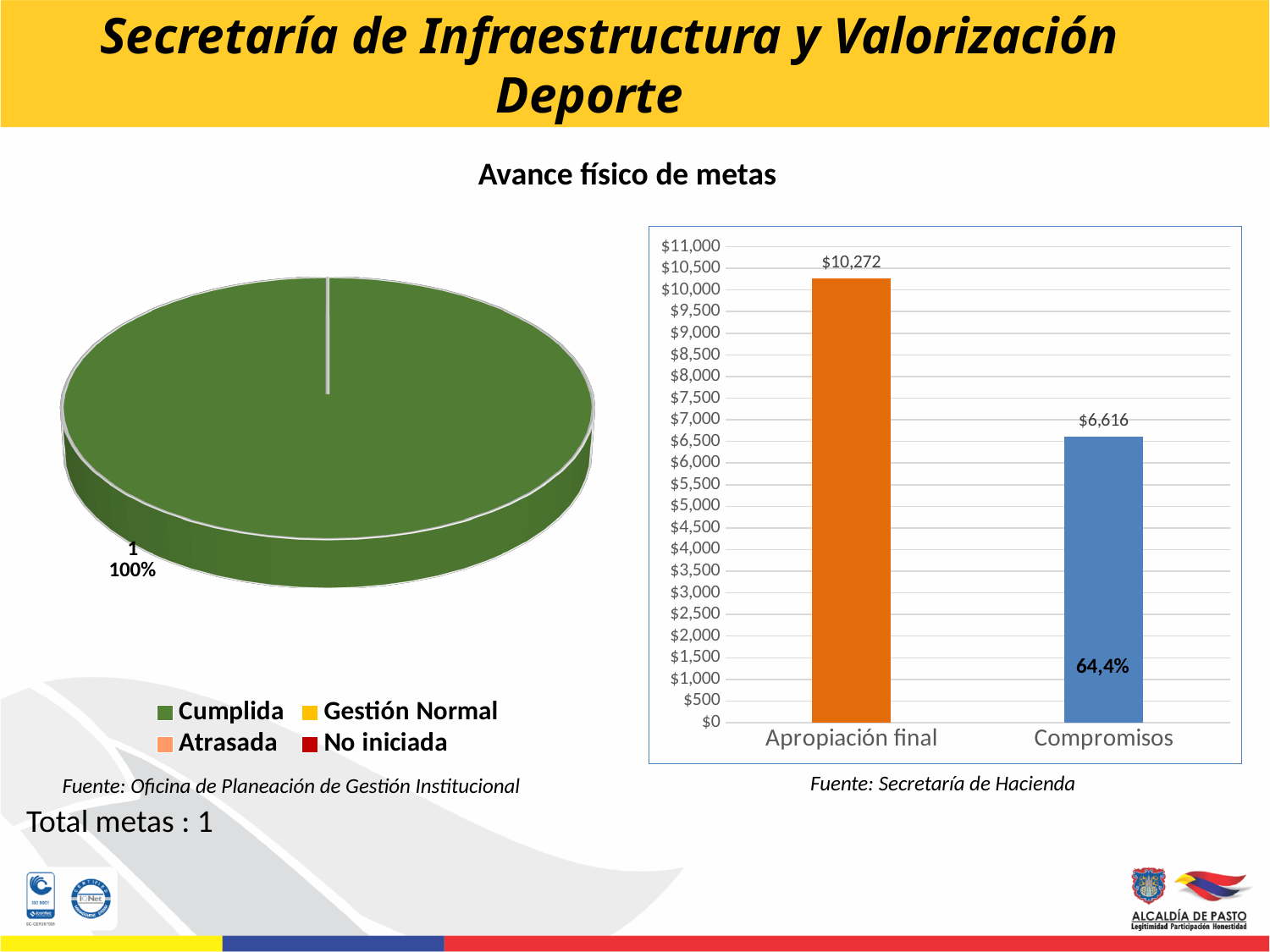
In the bar chart on the right, what percentage label is printed on the Compromisos bar? 64,4% In the bar chart on the right, which category has the lower value? Compromisos In the bar chart on the right, what is the difference between Apropiación final and Compromisos? $3,656 In the pie chart on the left, what share does the Cumplida slice represent? 100% In the bar chart on the right, which category has the higher value? Apropiación final In the bar chart on the right, how many categories are shown on the x axis? 2 What kind of chart is shown on the right side of the slide? bar chart In the pie chart on the left, how many entries does the legend list? 4 In the bar chart on the right, is the value for Compromisos greater or less than $7,000? less What kind of chart is shown on the left side of the slide? pie chart In the bar chart on the right, what is the value for Apropiación final? $10,272 In the bar chart on the right, what is the value for Compromisos? $6,616